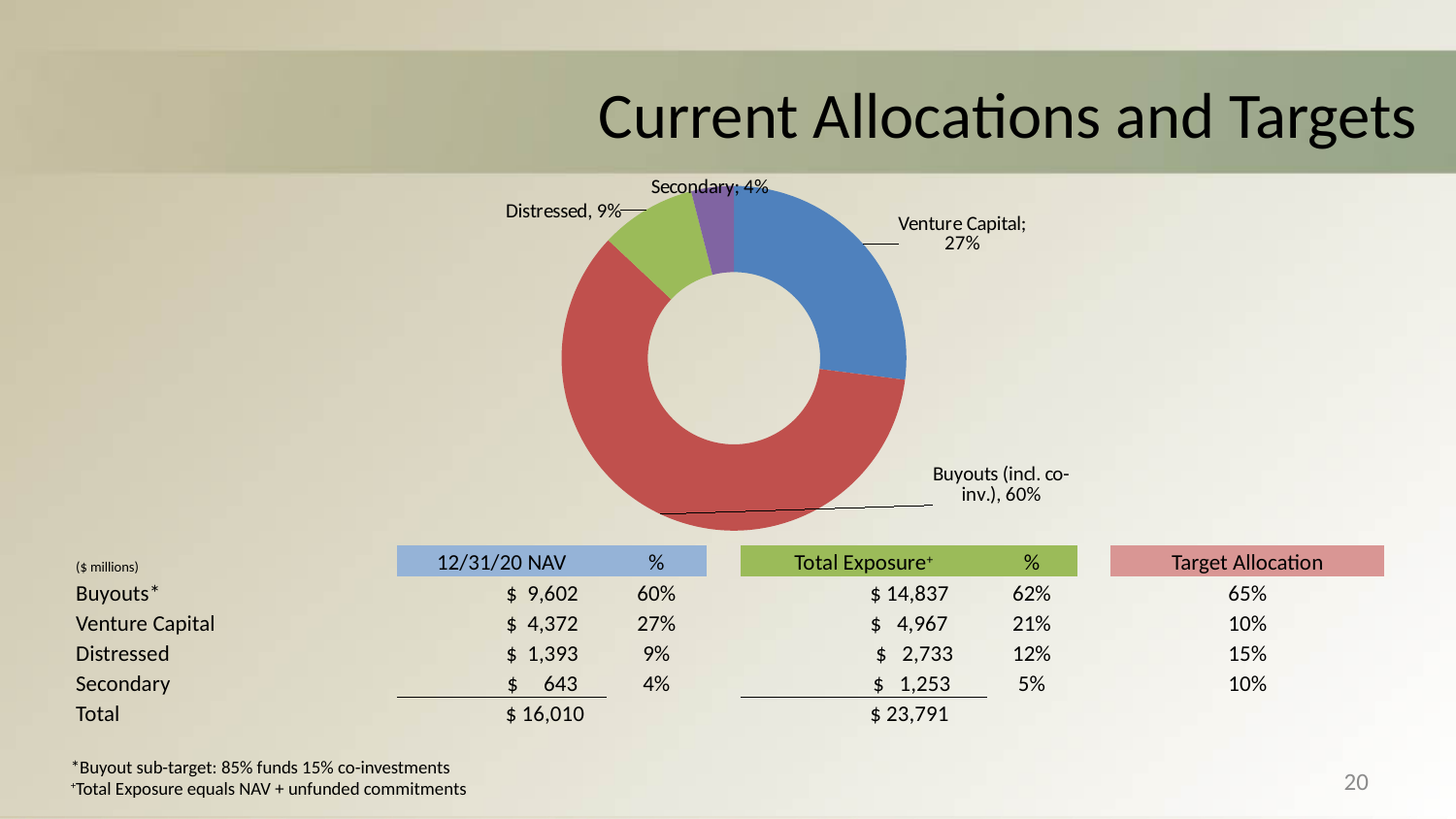
What is the difference in percentage points between the Buyouts (incl. co-inv.) slice and the Venture Capital slice? 33 percentage points How many slices does the donut chart have? 4 What share of the donut chart does Distressed represent? 9% What is the title of the slide containing the donut chart? Current Allocations and Targets What share of the donut chart does Venture Capital represent? 27% What share of the donut chart does Secondary represent? 4% What kind of chart is shown on the slide? Donut (pie) chart Which slice is larger, Distressed or Secondary? Distressed What is the difference in percentage points between the Distressed slice and the Secondary slice? 5 percentage points Which category has the largest slice in the donut chart? Buyouts (incl. co-inv.) Which category has the smallest slice in the donut chart? Secondary